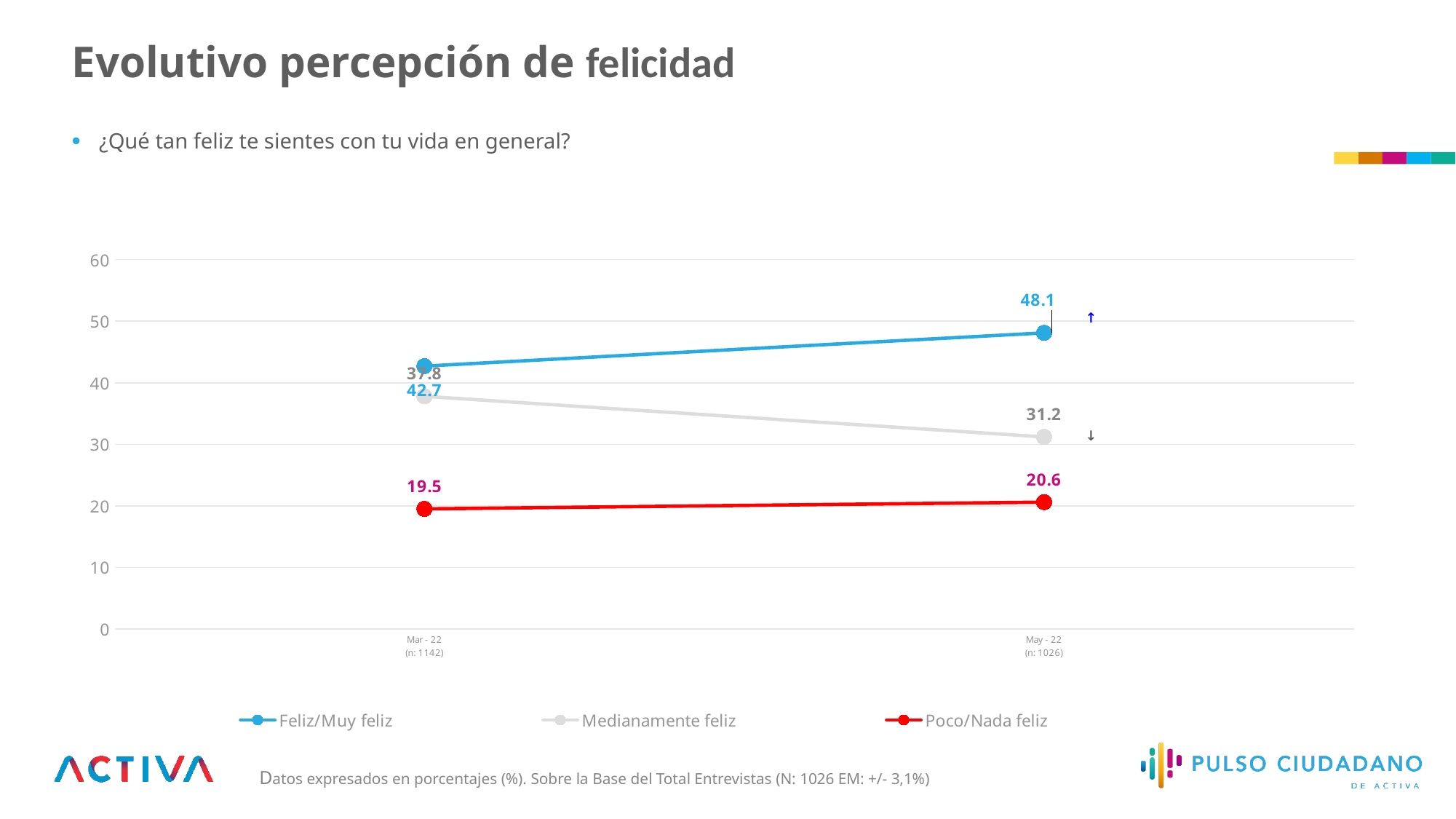
What type of chart is shown on the slide? line chart What is the value for Poco/Nada feliz in May - 22? 20.6 How many time points are plotted on the x axis? 2 How many series does the legend list? 3 Which is larger: Medianamente feliz in May - 22 or Poco/Nada feliz in May - 22? Medianamente feliz Which series has the lowest value in Mar - 22? Poco/Nada feliz By how much did Feliz/Muy feliz change from Mar - 22 to May - 22? 5.4 Does the Medianamente feliz series rise or fall from Mar - 22 to May - 22? fall What is the value for Medianamente feliz in Mar - 22? 37.8 What is the value for Feliz/Muy feliz in May - 22? 48.1 Which series has the highest value in May - 22? Feliz/Muy feliz What is the sample size (n) shown for May - 22? 1026